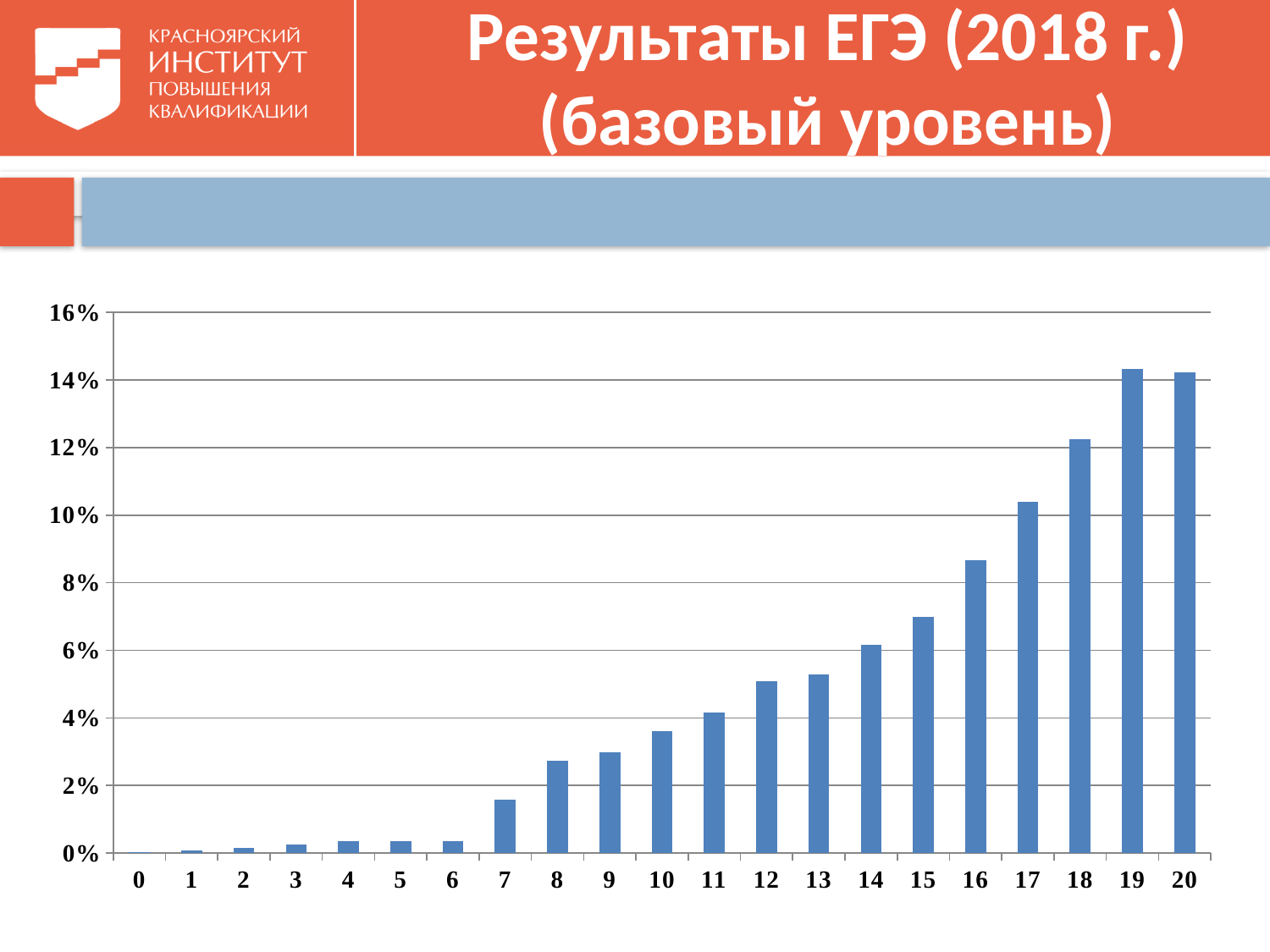
How many categories are shown on the x axis of the chart? 21 Is the value for category 17 greater or less than 10%? greater Which has the larger value, category 13 or category 17? 17 Is the value for category 18 greater or less than 14%? less Which category has the lowest value in the chart? 0 Is the value for category 15 greater or less than 6%? greater What kind of chart is shown on the slide? bar chart Do the values generally rise or fall as the categories go from 0 to 20? rise What is the title of the slide containing the chart? Результаты ЕГЭ (2018 г.) (базовый уровень)